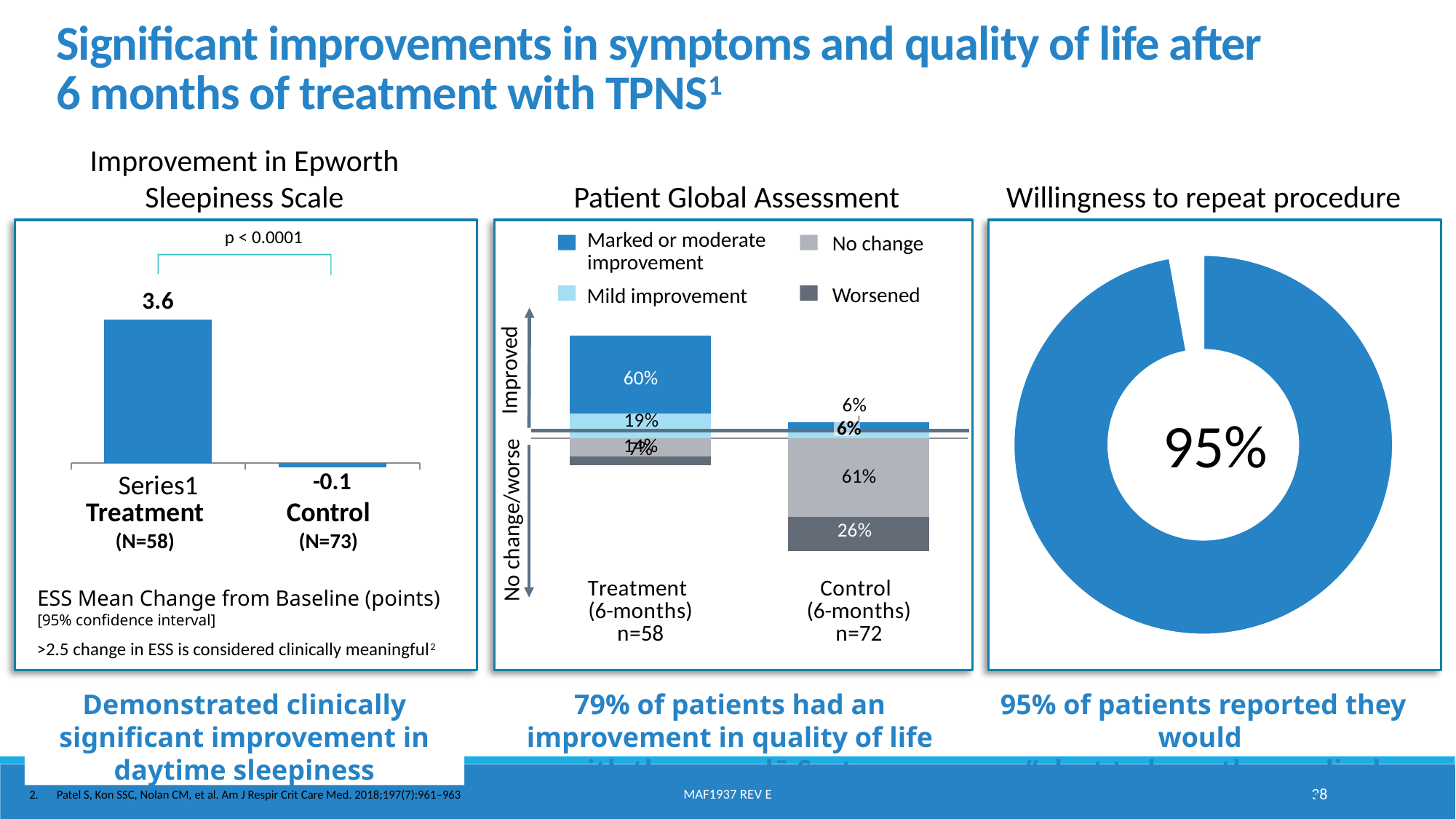
In the Improvement in Epworth Sleepiness Scale chart, what is the difference between the Treatment and Control ESS mean change values? 3.7 In the Patient Global Assessment chart, what percentage of Control patients had no change? 61% In the Improvement in Epworth Sleepiness Scale chart, which group has the higher ESS mean change from baseline? Treatment In the Improvement in Epworth Sleepiness Scale chart, what is the ESS mean change from baseline for the Control group? -0.1 In the Patient Global Assessment chart, what percentage of Treatment patients had mild improvement? 19% In the Improvement in Epworth Sleepiness Scale chart, what p-value is shown between the two groups? p < 0.0001 In the Patient Global Assessment chart, what percentage of Treatment patients had marked or moderate improvement? 60% In the Patient Global Assessment chart, what percentage of Control patients worsened? 26% In the Improvement in Epworth Sleepiness Scale chart, what is the ESS mean change from baseline for the Treatment group? 3.6 What kind of chart is the Willingness to repeat procedure chart? Donut chart In the Willingness to repeat procedure chart, what percentage is shown in the centre? 95% In the Patient Global Assessment chart, how many series does the legend list? 4